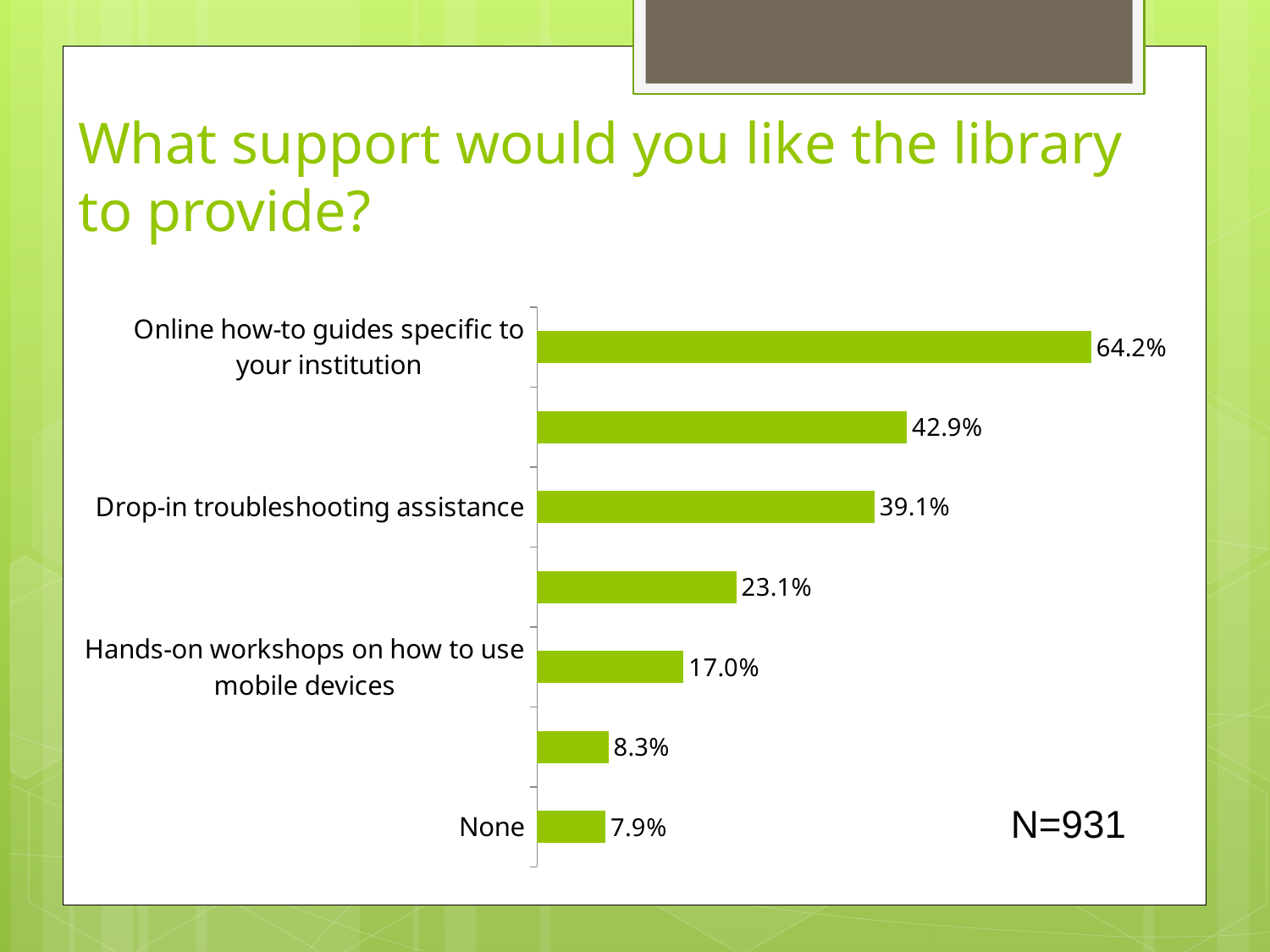
What sample size (N) is shown on the slide? N=931 What is the value for "Online how-to guides specific to your institution"? 64.2% What is the value for "Hands-on workshops on how to use mobile devices"? 17.0% How many bars are plotted in the chart? 7 Which category has the highest value? Online how-to guides specific to your institution What is the difference between the values for "Online how-to guides specific to your institution" and "Drop-in troubleshooting assistance"? 25.1% What is the difference between the values for "Hands-on workshops on how to use mobile devices" and "None"? 9.1% What kind of chart is shown on the slide? bar chart Which is larger, the value for "Drop-in troubleshooting assistance" or the value for "Hands-on workshops on how to use mobile devices"? Drop-in troubleshooting assistance What is the value for "None"? 7.9% What is the value for "Drop-in troubleshooting assistance"? 39.1% Which category has the lowest value? None